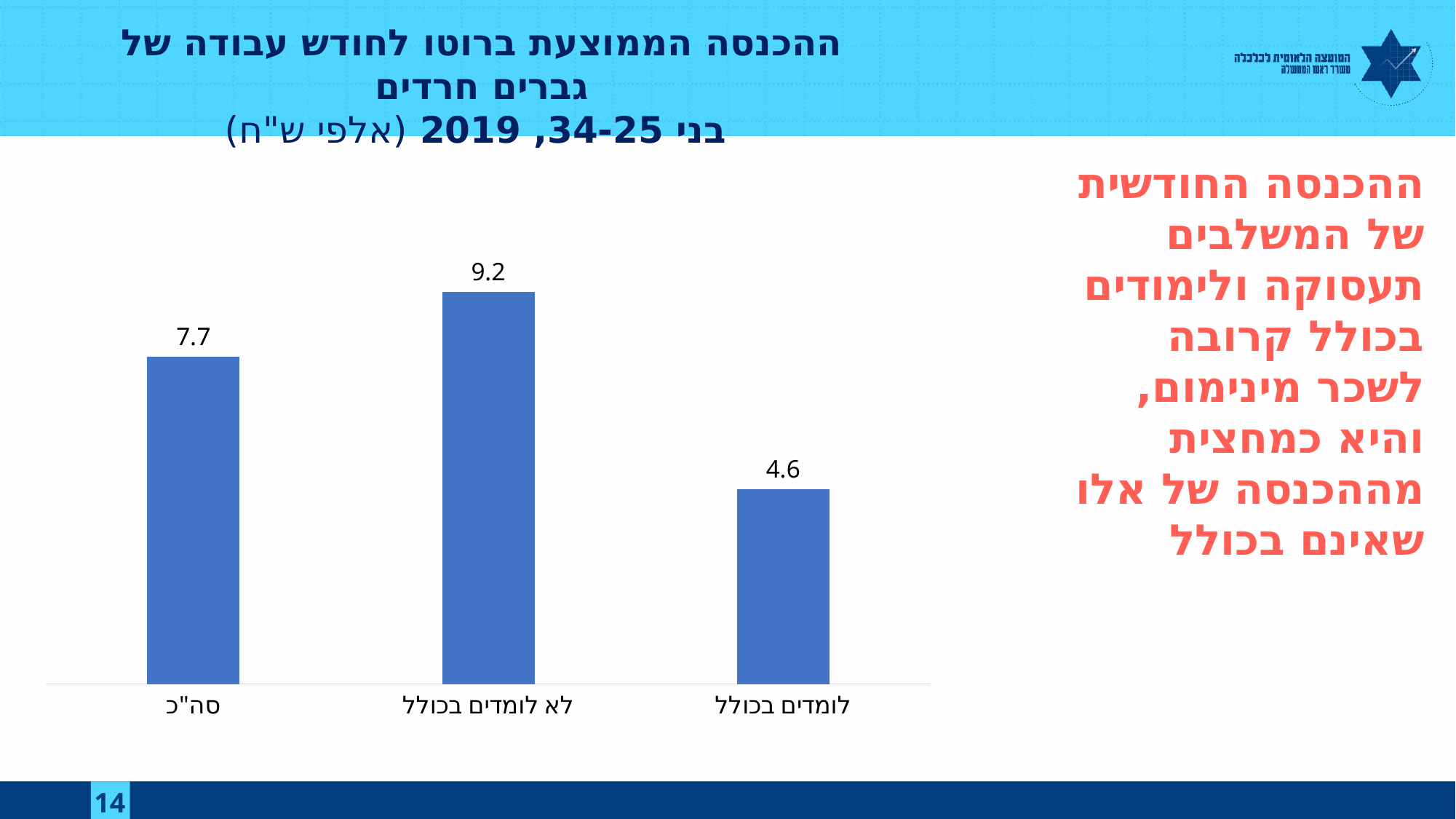
What is the value for לא לומדים בכולל? 9.2 Which category has the highest value? לא לומדים בכולל What is the value for לומדים בכולל? 4.6 What is the difference between the values for לא לומדים בכולל and לומדים בכולל? 4.6 What kind of chart is shown on the slide? bar chart What is the difference between the values for לא לומדים בכולל and סה"כ? 1.5 How many categories are shown in the chart? 3 What is the value for סה"כ? 7.7 What year does the chart title say the data is for? 2019 Which is larger, the value for סה"כ or the value for לומדים בכולל? סה"כ What unit does the chart title give for the values? אלפי ש"ח Which category has the lowest value? לומדים בכולל